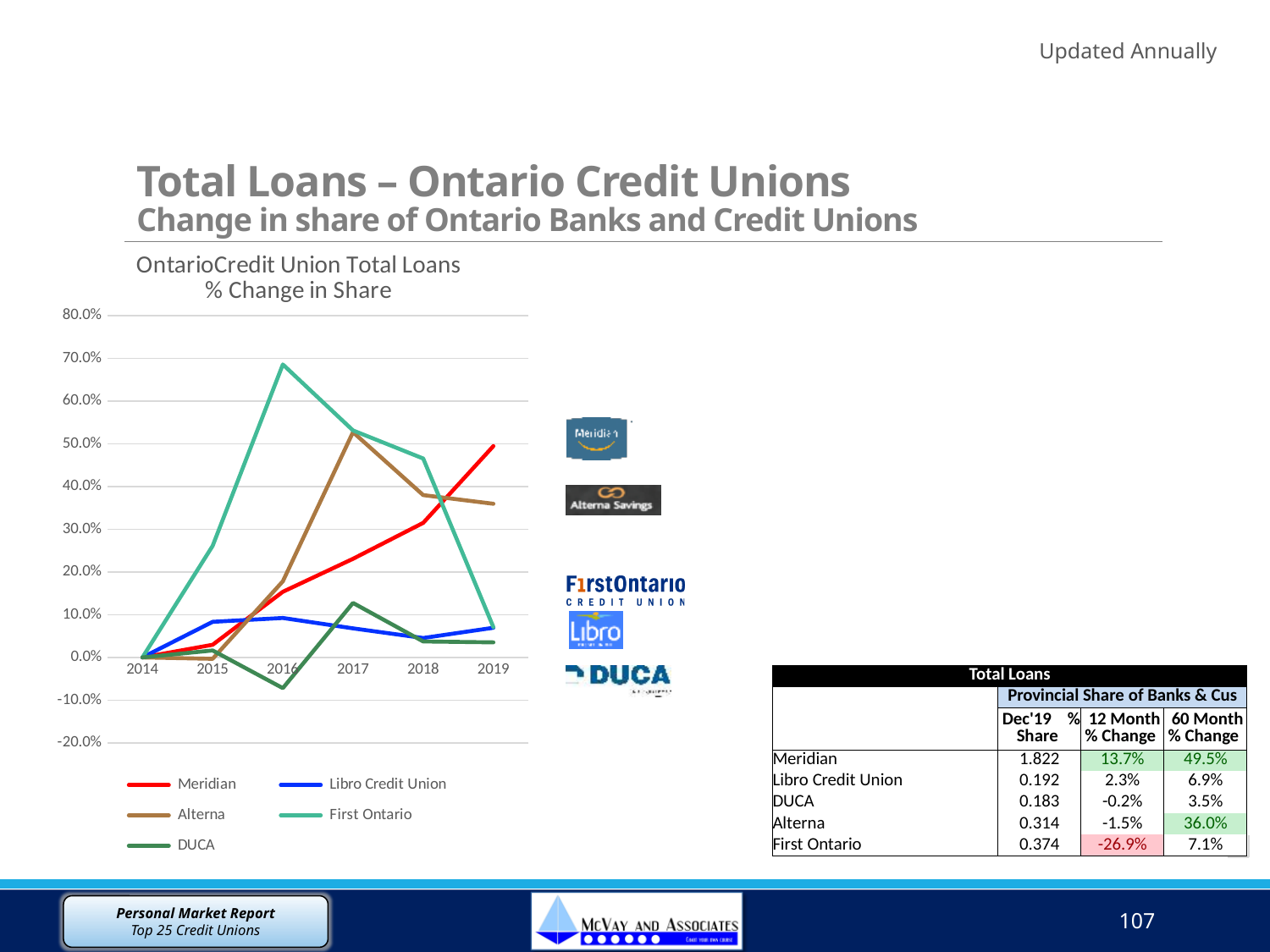
In 2017, which is larger: the value for Alterna or the value for Meridian? Alterna Is the value for Meridian in 2019 greater or less than 40.0%? greater How many series does the legend of the chart list? 5 What kind of chart is shown on the slide? line chart Which series has the highest value in 2019? Meridian How many years are shown along the x axis of the chart? 6 Which series has the lowest value in 2016? DUCA Does the Meridian line rise or fall from 2014 to 2019? rises Which series reaches the highest point anywhere on the chart? First Ontario Does the First Ontario line rise or fall from 2016 to 2019? falls Is the value for First Ontario in 2016 greater or less than 60.0%? greater Is the value for DUCA in 2016 greater or less than 0.0%? less